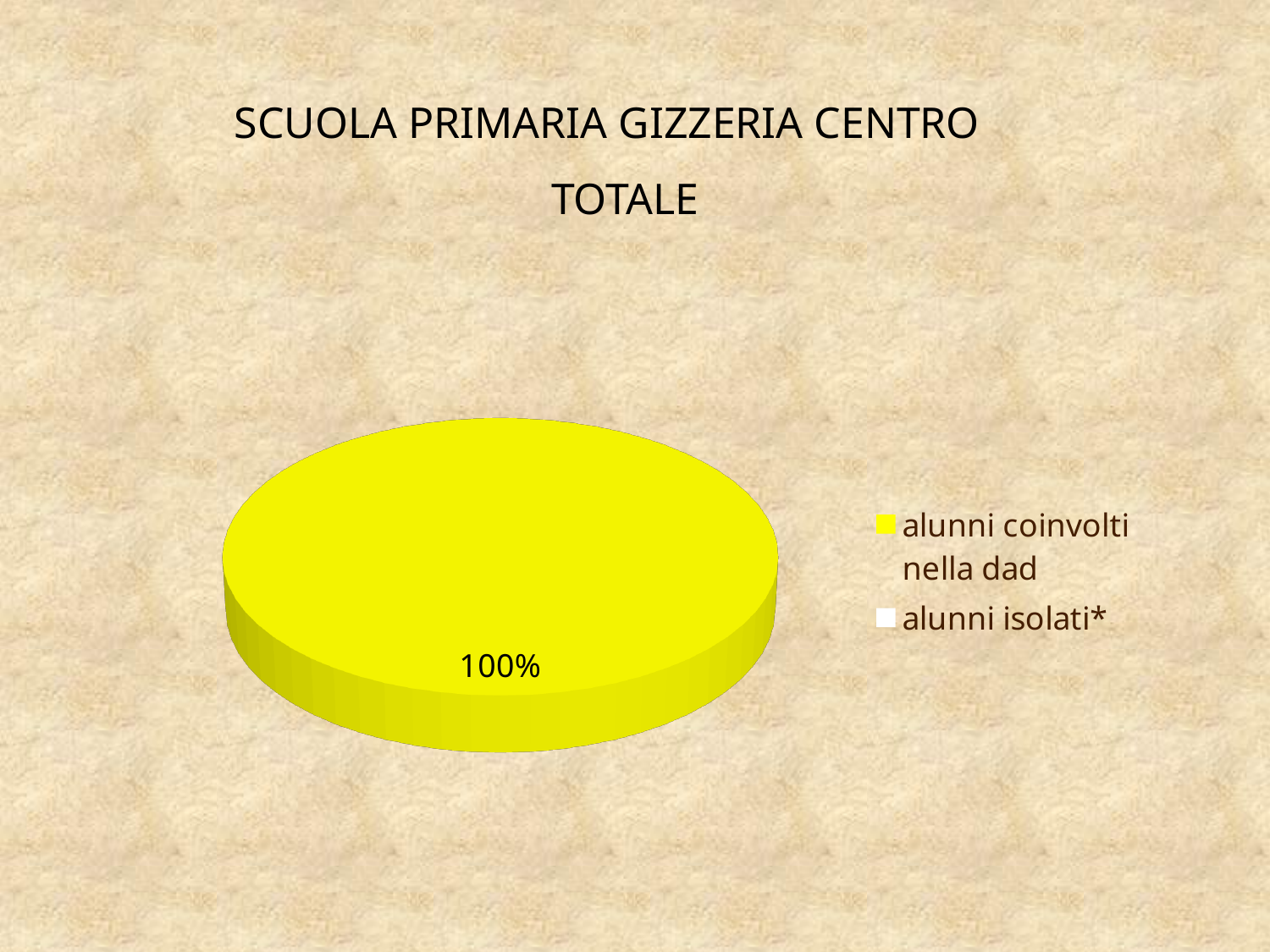
What kind of chart is shown on the slide? pie chart What share of the pie does "alunni coinvolti nella dad" represent? 100% What is the title of the chart? SCUOLA PRIMARIA GIZZERIA CENTRO TOTALE Is the share for "alunni coinvolti nella dad" greater or less than 50%? greater What colour is the slice for "alunni coinvolti nella dad"? yellow Which category makes up the largest share of the pie? alunni coinvolti nella dad How many entries does the legend list? 2 Which is larger, the share for "alunni coinvolti nella dad" or the share for "alunni isolati*"? alunni coinvolti nella dad Which legend category has the smallest share of the pie? alunni isolati*